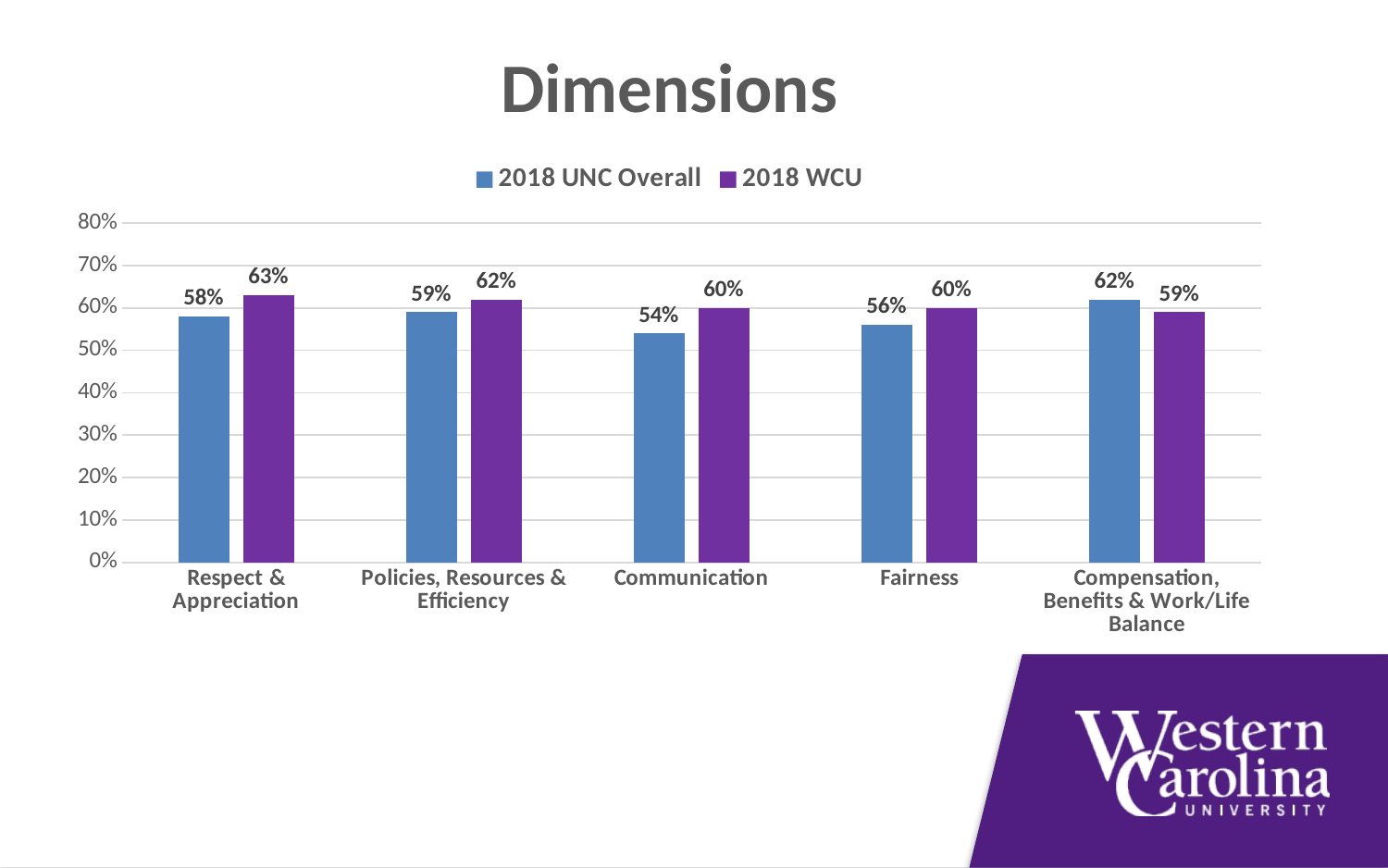
Which category has the lowest 2018 UNC Overall value? Communication Which category has the highest 2018 WCU value? Respect & Appreciation What is the 2018 WCU value for Communication? 60% What colour are the 2018 WCU bars? Purple What is the 2018 UNC Overall value for Compensation, Benefits & Work/Life Balance? 62% What is the title of the slide? Dimensions How many series does the legend list? 2 What kind of chart is shown on the slide? Bar chart What is the 2018 UNC Overall value for Fairness? 56% How many categories are shown on the x axis? 5 What is the difference between the 2018 WCU and 2018 UNC Overall values for Communication? 6% Which is larger for Compensation, Benefits & Work/Life Balance: 2018 UNC Overall or 2018 WCU? 2018 UNC Overall